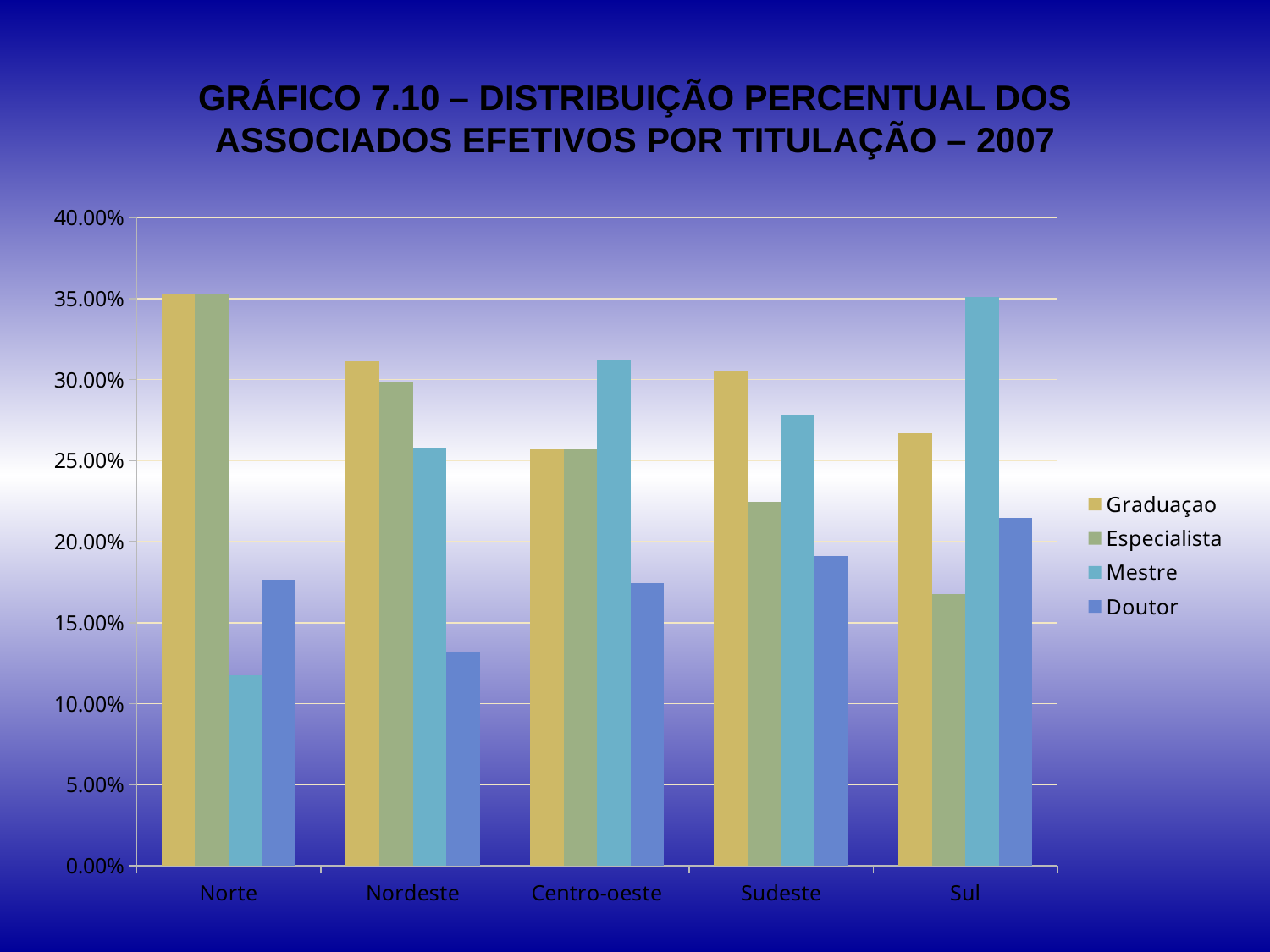
How many regions are shown on the x axis of the chart? 5 Is the Mestre value for Norte greater or less than 15.00%? less Is the Mestre value for Sul greater or less than 30.00%? greater Which region has the lowest Mestre value? Norte Which region has the highest Mestre value? Sul For Centro-oeste, which is larger: Mestre or Graduaçao? Mestre Which series are listed in the legend? Graduaçao, Especialista, Mestre, Doutor Is the Especialista value for Sul greater or less than 20.00%? less For Sudeste, which is larger: Graduaçao or Especialista? Graduaçao How many series does the legend list? 4 What kind of chart is shown on the slide? bar chart Which region has the lowest Doutor value? Nordeste